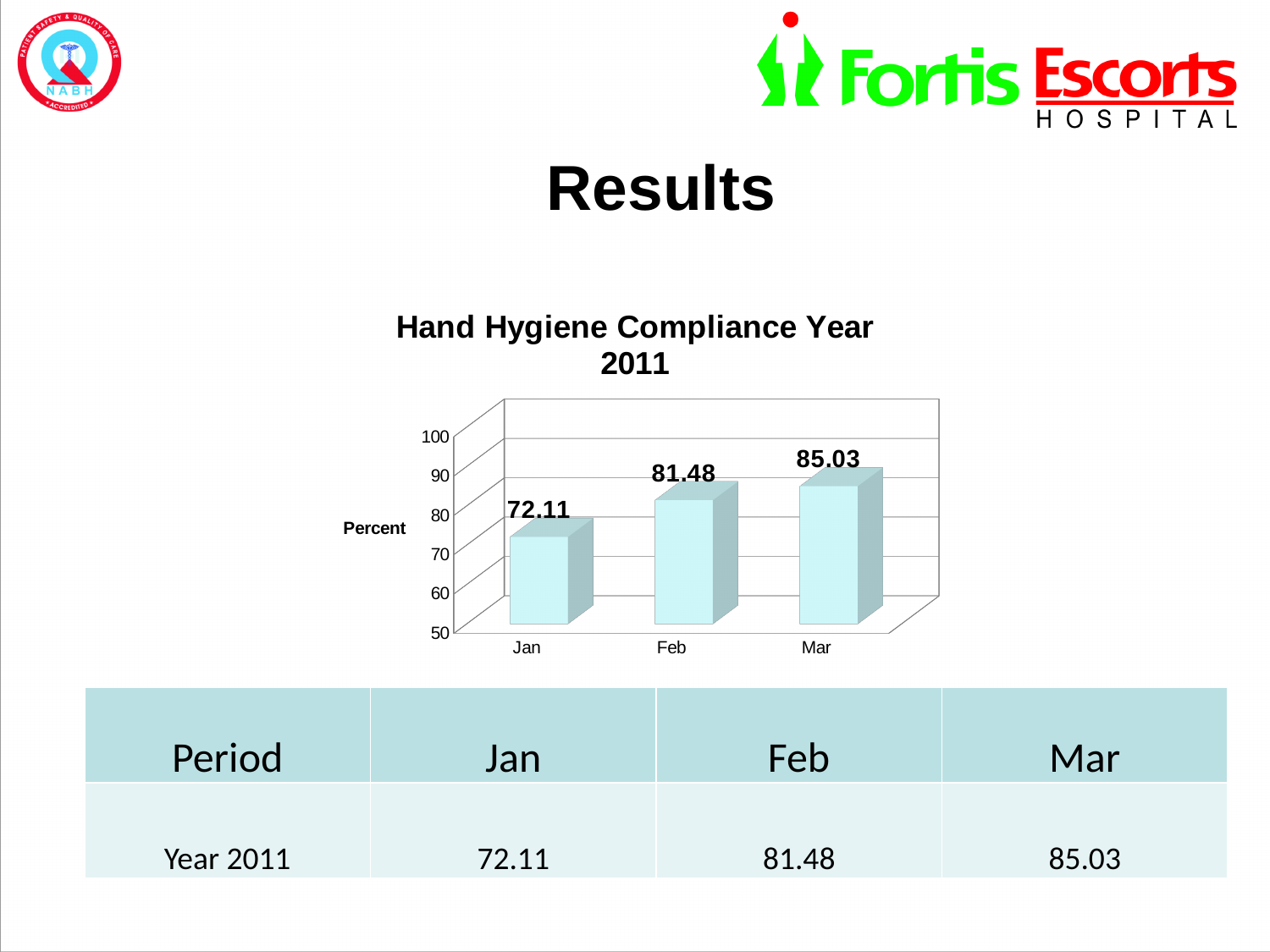
Do the compliance values rise or fall from Jan to Mar? rise What is the hand hygiene compliance value for Feb? 81.48 Which month has the highest hand hygiene compliance? Mar Which is larger, the value for Feb or the value for Jan? Feb Is the value for Jan greater or less than 80? less Which month has the lowest hand hygiene compliance? Jan What kind of chart is shown on the slide? bar chart What is the difference between the Feb and Jan compliance values? 9.37 What is the hand hygiene compliance value for Jan? 72.11 What is the difference between the Mar and Jan compliance values? 12.92 What is the hand hygiene compliance value for Mar? 85.03 How many months are shown on the chart? 3